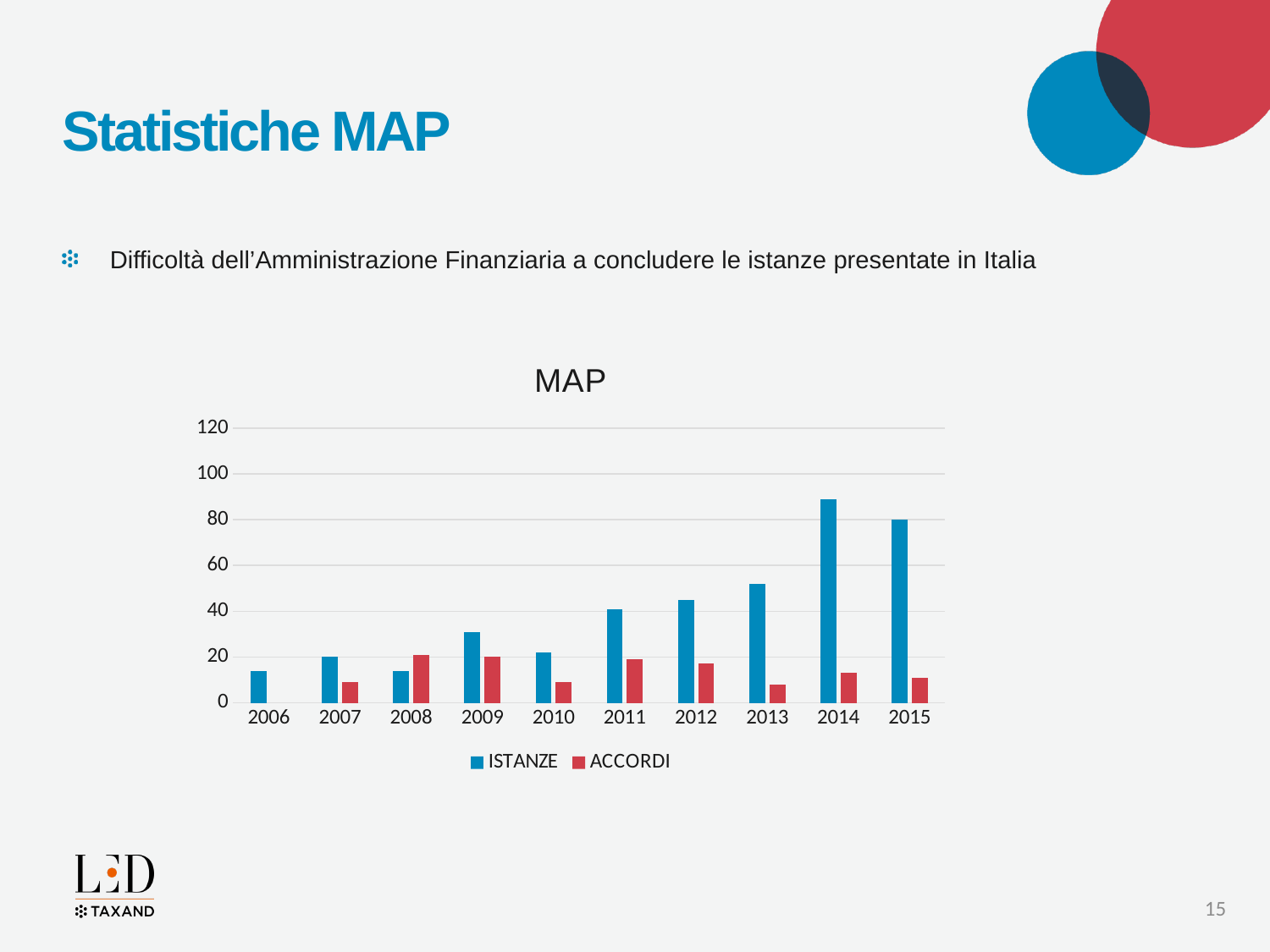
What type of chart is shown on the slide? bar chart Is the ISTANZE value for 2013 greater or less than 60? less Which colour represents the ACCORDI series in the chart? red How many series does the legend list? 2 Is the ACCORDI value for 2012 greater or less than 20? less Is the ISTANZE value for 2014 greater or less than 80? greater Which year has the highest ISTANZE value? 2014 In 2008, which is larger, ISTANZE or ACCORDI? ACCORDI Which is larger, the ISTANZE value for 2014 or for 2015? 2014 What is the title of the chart? MAP How many years are shown on the x axis of the chart? 10